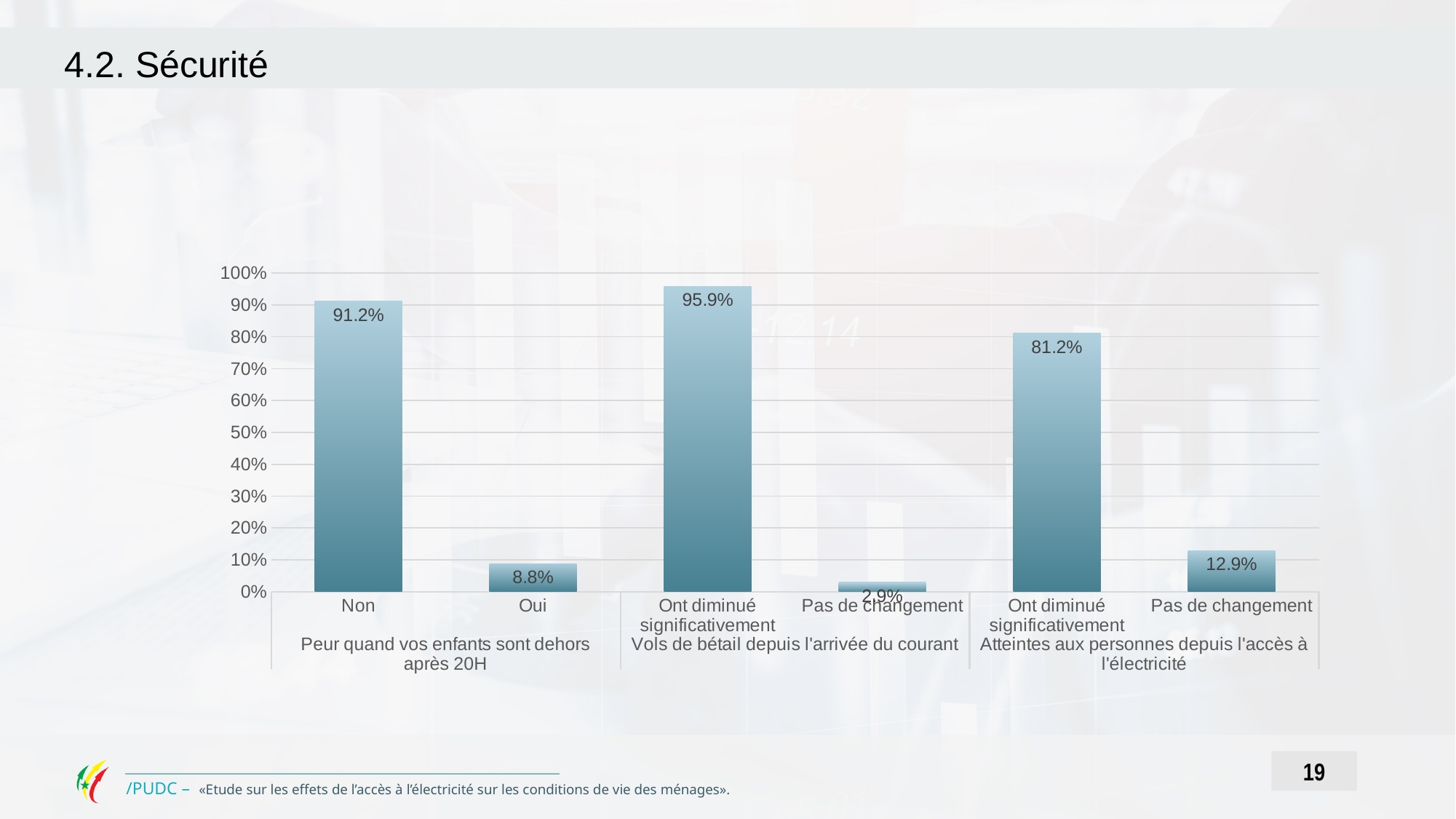
What kind of chart is shown on the slide? bar chart Which is larger: "Oui" under "Peur quand vos enfants sont dehors après 20H" or "Pas de changement" under "Atteintes aux personnes depuis l'accès à l'électricité"? Pas de changement (Atteintes aux personnes depuis l'accès à l'électricité) How many bars are plotted on the chart? 6 What is the value for "Oui" under "Peur quand vos enfants sont dehors après 20H"? 8.8% What is the value for "Pas de changement" under "Atteintes aux personnes depuis l'accès à l'électricité"? 12.9% What is the value for "Ont diminué significativement" under "Atteintes aux personnes depuis l'accès à l'électricité"? 81.2% Which bar has the highest value on the chart? Ont diminué significativement (Vols de bétail depuis l'arrivée du courant) What is the value for "Ont diminué significativement" under "Vols de bétail depuis l'arrivée du courant"? 95.9% What is the value for "Pas de changement" under "Vols de bétail depuis l'arrivée du courant"? 2.9% What is the value for "Non" under "Peur quand vos enfants sont dehors après 20H"? 91.2% Which bar has the lowest value on the chart? Pas de changement (Vols de bétail depuis l'arrivée du courant) What is the difference between "Ont diminué significativement" and "Pas de changement" under "Atteintes aux personnes depuis l'accès à l'électricité"? 68.3%